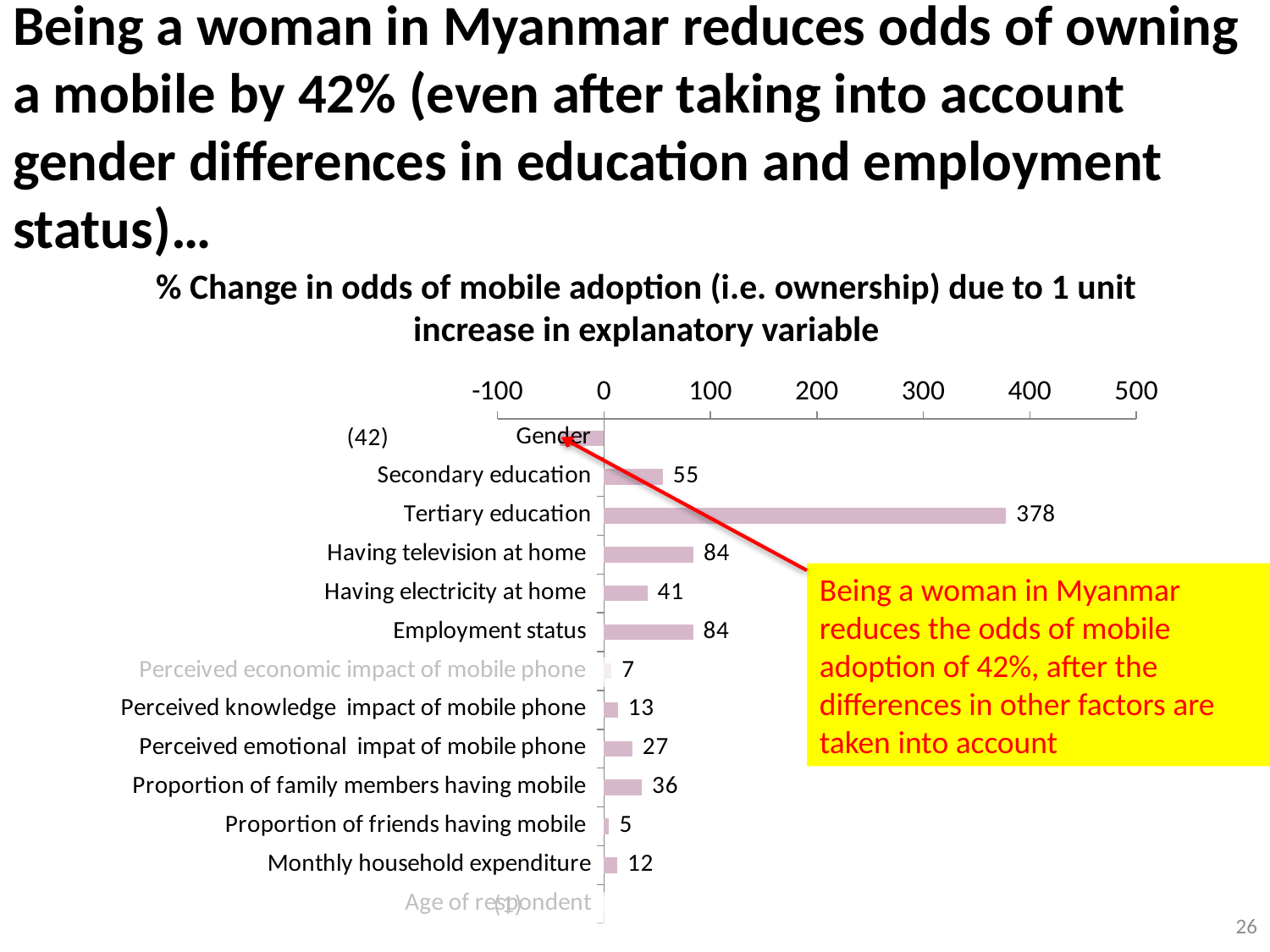
What is the value for Proportion of friends having mobile? 5 What is the value shown for Gender? (42) What type of chart is shown on the slide? bar chart Which category has the highest value? Tertiary education What is the title of the chart? % Change in odds of mobile adoption (i.e. ownership) due to 1 unit increase in explanatory variable Is the value for Tertiary education greater or less than 300? greater Which category has the lowest value? Gender What is the value for Having electricity at home? 41 Which is larger, the value for Having television at home or the value for Having electricity at home? Having television at home What is the difference between the values for Tertiary education and Secondary education? 323 What is the value for Tertiary education? 378 What is the value for Secondary education? 55